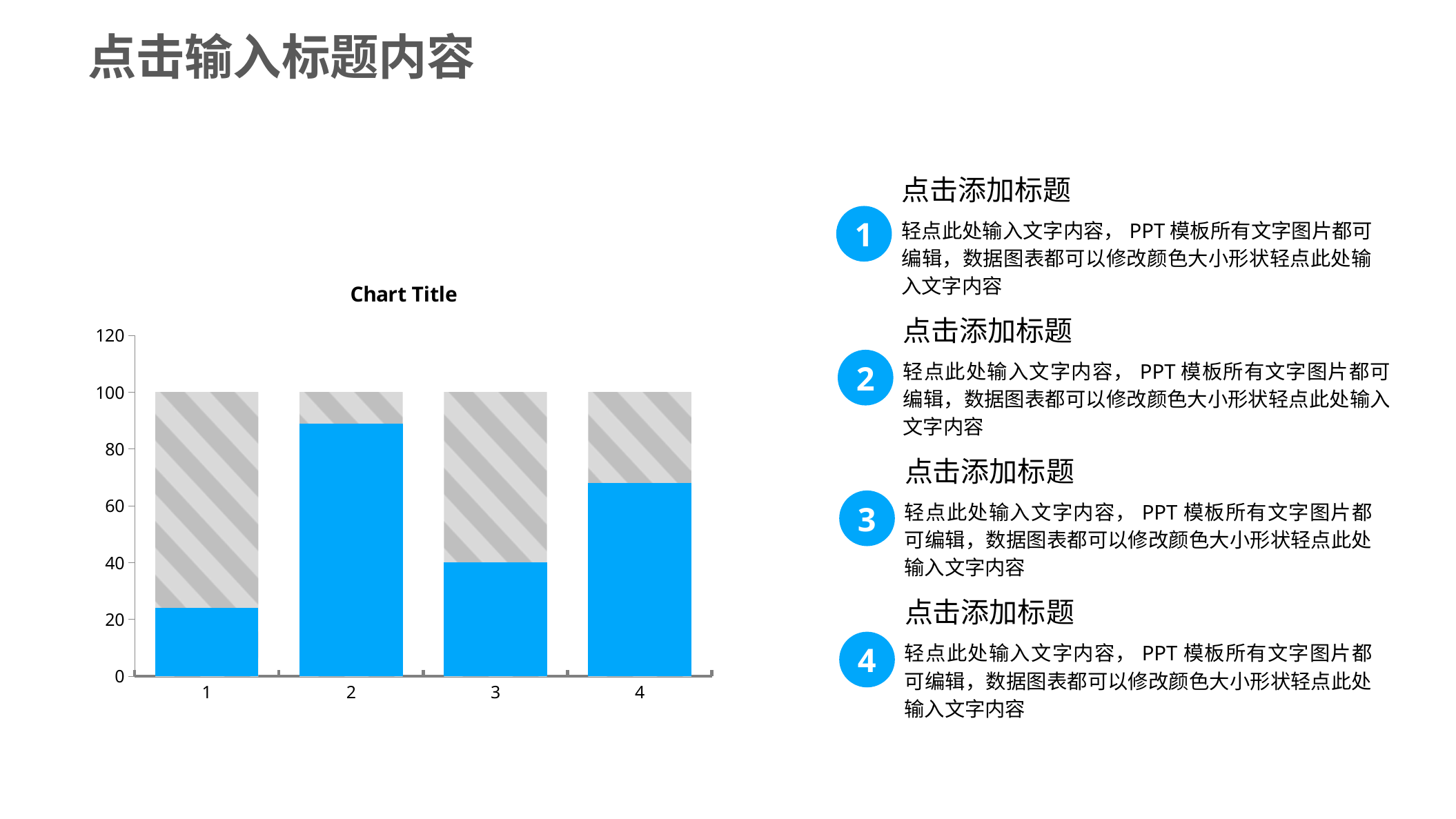
What is the highest value shown on the vertical axis of the chart? 120 Which has the larger blue segment, category 3 or category 4? 4 Is the blue value for category 4 greater or less than 60? greater Which category has the shortest blue segment? 1 Which category has the tallest blue segment? 2 What is the title of the chart? Chart Title What kind of chart is shown on the slide? bar chart Is the blue value for category 1 greater or less than 40? less How many categories are shown on the x axis of the chart? 4 What is the total height of the stacked bar for category 2? 100 Is the blue value for category 2 greater or less than 80? greater Which has the larger blue segment, category 1 or category 3? 3